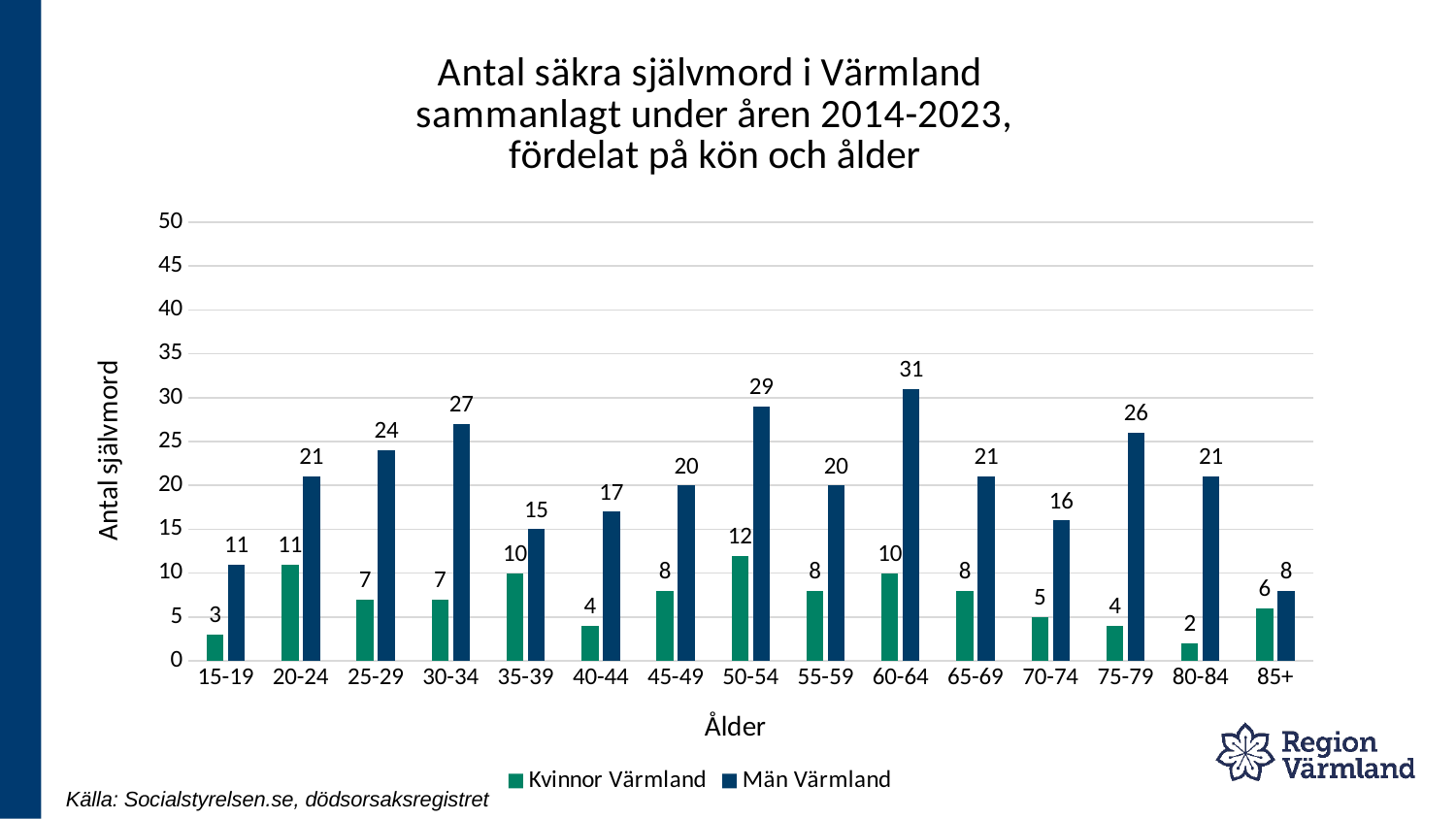
How many age groups are shown on the x axis? 15 Which age group has the highest value for Män Värmland? 60-64 What is the label of the y axis? Antal självmord How many series does the legend list? 2 What is the value for Kvinnor Värmland in the 50-54 age group? 12 What is the value for Kvinnor Värmland in the 15-19 age group? 3 What kind of chart is shown on the slide? Bar chart What is the value for Män Värmland in the 60-64 age group? 31 Is the value for Män Värmland in the 75-79 age group greater or less than 20? greater Which is larger in the 85+ age group, Kvinnor Värmland or Män Värmland? Män Värmland What is the difference between Män Värmland and Kvinnor Värmland in the 30-34 age group? 20 Which age group has the lowest value for Kvinnor Värmland? 80-84